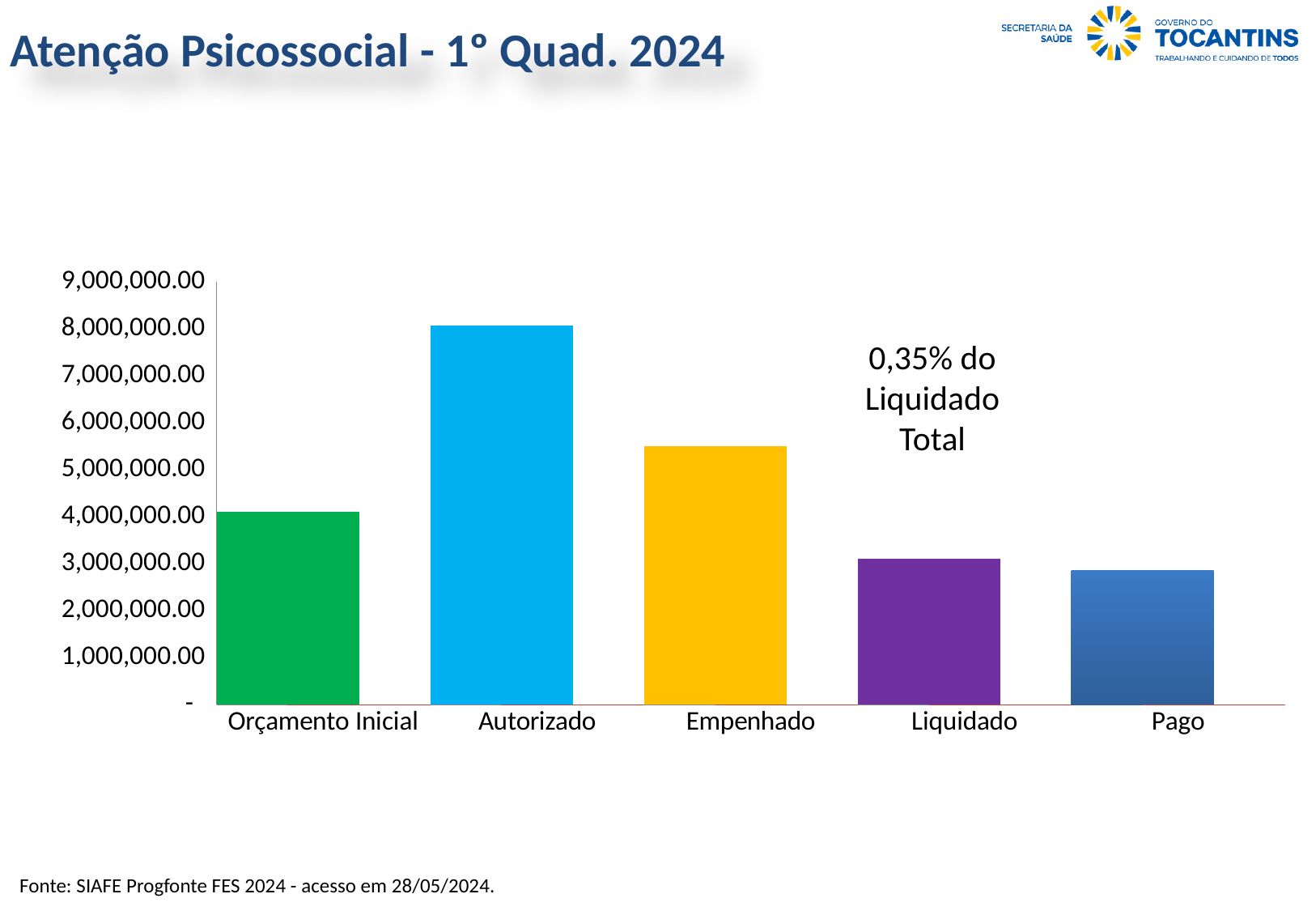
Is the value for Pago greater or less than 3,000,000.00? less Is the value for Autorizado greater or less than 7,000,000.00? greater Is the value for Empenhado greater or less than 5,000,000.00? greater Which category has the lowest value in the chart? Pago What kind of chart is shown on the slide? bar chart Which is larger, the value for Liquidado or the value for Pago? Liquidado How many categories are shown on the x axis of the chart? 5 What percentage of the total Liquidado does the annotation on the chart state? 0,35% Which is larger, the value for Empenhado or the value for Orçamento Inicial? Empenhado Which category has the highest value in the chart? Autorizado